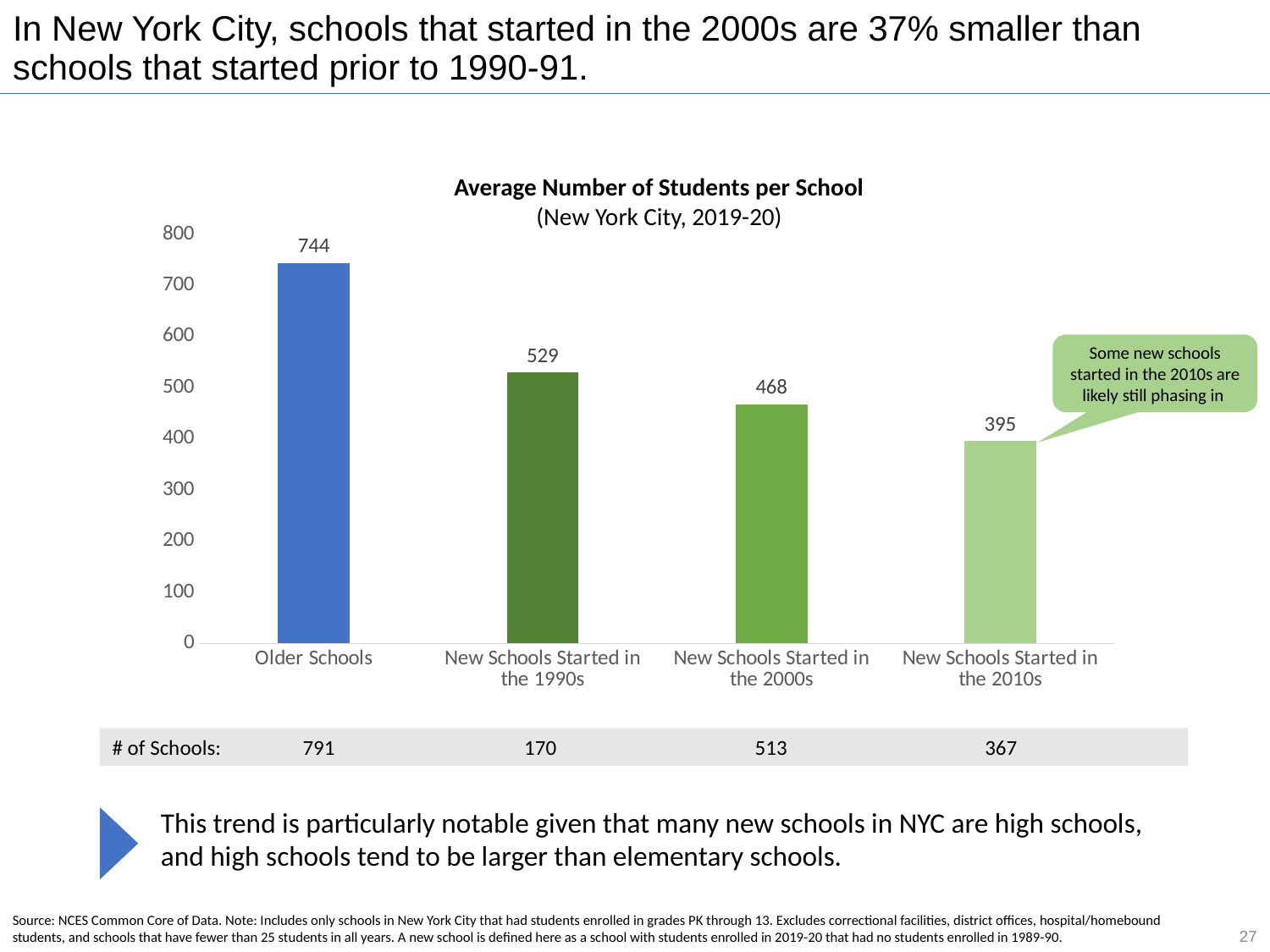
Which category has the highest average number of students per school? Older Schools What is the average number of students per school for Older Schools? 744 What is the difference in average students per school between Older Schools and New Schools Started in the 2000s? 276 How many categories are shown on the chart? 4 Which has a higher average number of students per school: New Schools Started in the 1990s or New Schools Started in the 2000s? New Schools Started in the 1990s What does the callout on the chart say about schools started in the 2010s? Some new schools started in the 2010s are likely still phasing in What is the average number of students per school for New Schools Started in the 1990s? 529 What type of chart is shown on the slide? Bar chart Which category has the lowest average number of students per school? New Schools Started in the 2010s What is the average number of students per school for New Schools Started in the 2010s? 395 What is the title of the chart? Average Number of Students per School Do the values rise or fall moving from left to right across the categories? Fall